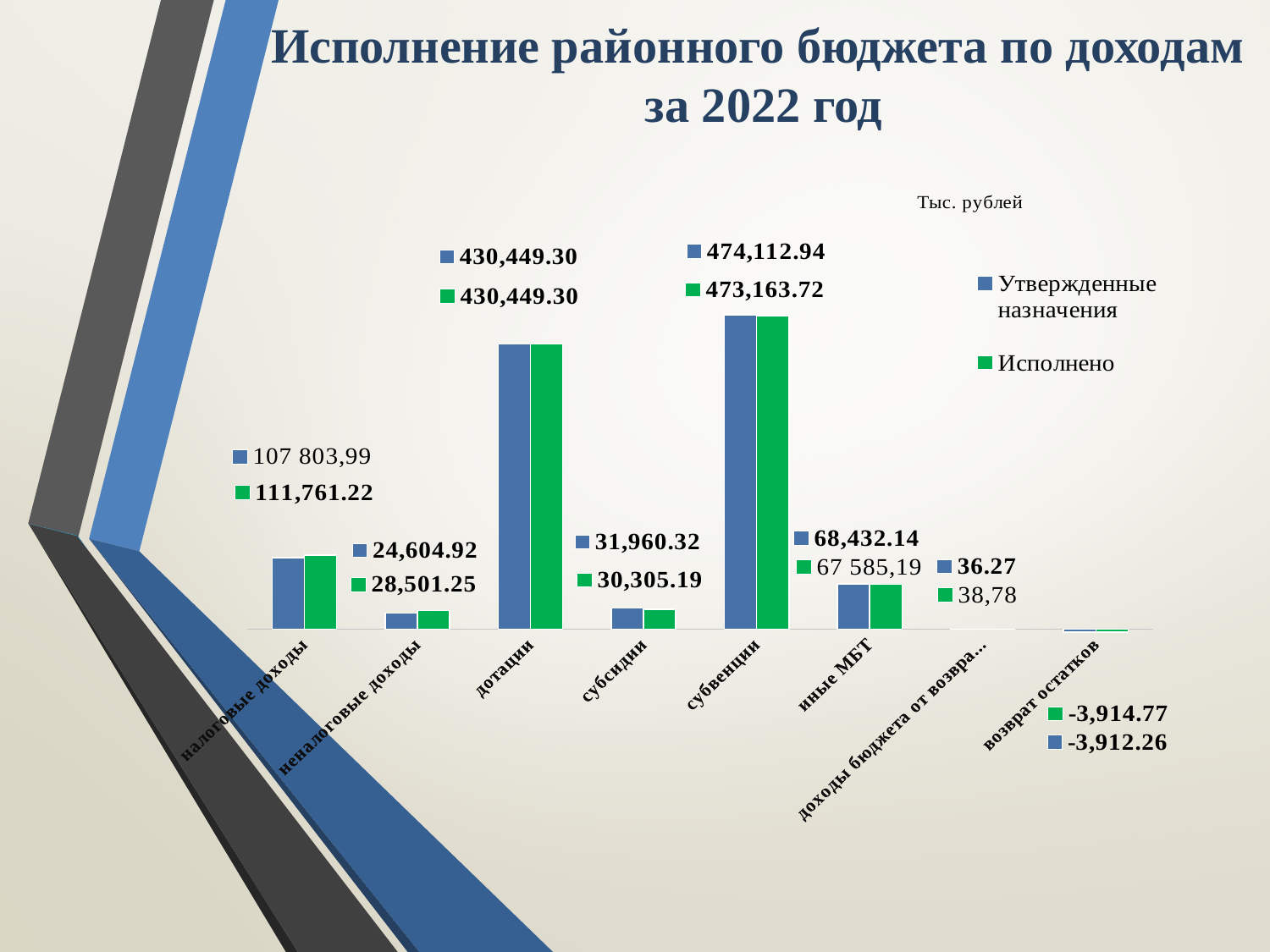
Which category has the highest value for Исполнено? субвенции What is the value of Утвержденные назначения for неналоговые доходы? 24,604.92 What is the value of Исполнено for налоговые доходы? 111,761.22 What type of chart is shown on the slide? Bar chart How many categories are shown on the x axis? 8 What is the difference between Утвержденные назначения and Исполнено for субсидии? 1,655.13 What is the value of Исполнено for иные МБТ? 67 585,19 What unit is stated above the chart? Тыс. рублей How many series does the legend list? 2 For налоговые доходы, which is larger: Утвержденные назначения or Исполнено? Исполнено Which category has the lowest value for Утвержденные назначения? возврат остатков What is the value of Утвержденные назначения for субвенции? 474,112.94